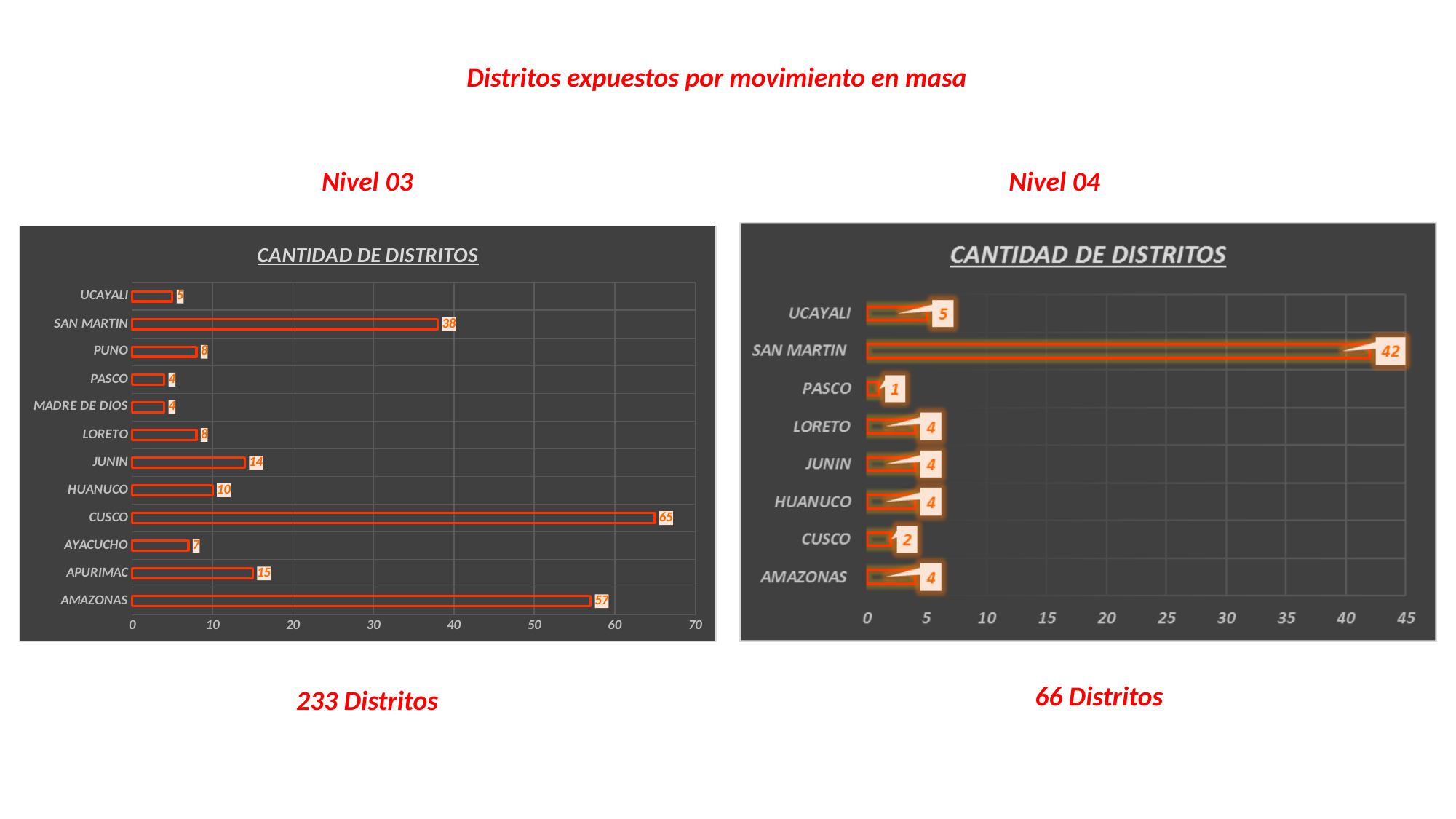
How many categories are shown in the Nivel 03 chart? 12 In the Nivel 03 chart, what is the value for HUANUCO? 10 In the Nivel 04 chart, what is the value for SAN MARTIN? 42 In the Nivel 03 chart, what is the value for CUSCO? 65 In the Nivel 04 chart, which category has the lowest value? PASCO In the Nivel 03 chart, which category has the highest value? CUSCO How many categories are shown in the Nivel 04 chart? 8 In the Nivel 04 chart, what is the difference between the values for SAN MARTIN and UCAYALI? 37 In the Nivel 03 chart, which is larger, the value for APURIMAC or the value for JUNIN? APURIMAC What kind of chart is the Nivel 04 chart? Bar chart What is the title shown inside the Nivel 03 chart? CANTIDAD DE DISTRITOS In the Nivel 03 chart, what is the difference between the values for CUSCO and AMAZONAS? 8